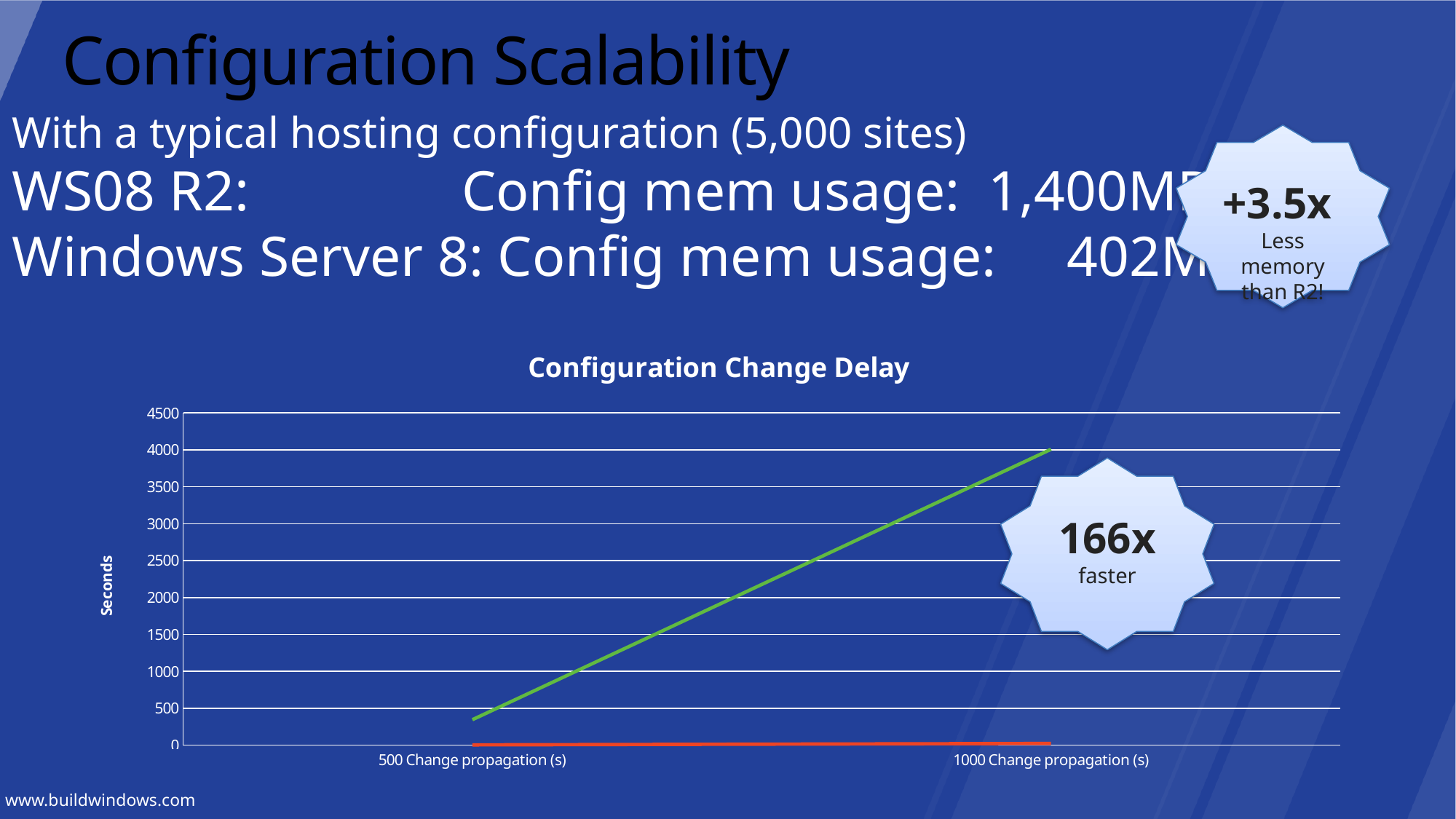
At which x-axis category does the green line reach its highest value? 1000 Change propagation (s) What is the title of the chart? Configuration Change Delay How many categories are shown on the x axis of the chart? 2 Is the value of the green line at 1000 Change propagation (s) greater or less than 3500? greater What is the label on the vertical axis of the chart? Seconds What is the highest value shown on the vertical axis of the chart? 4500 Is the value of the green line at 500 Change propagation (s) greater or less than 500? less Does the green line rise or fall from 500 Change propagation (s) to 1000 Change propagation (s)? rise At 1000 Change propagation (s), which line has the larger value, the green line or the red line? green line What kind of chart is shown on the slide? line chart Is the value of the red line at 1000 Change propagation (s) greater or less than 500? less